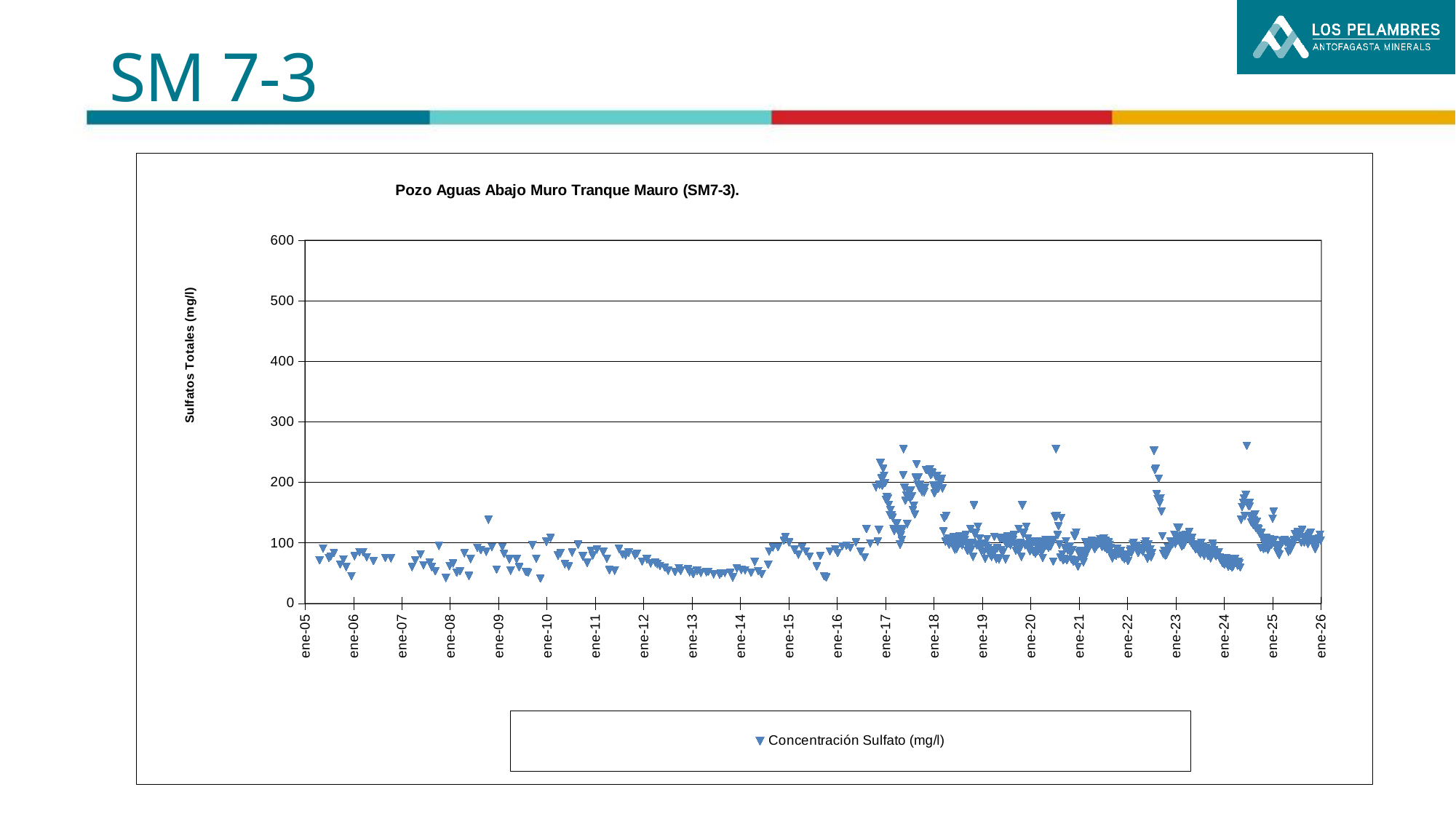
Do the plotted values generally rise or fall between ene-14 and ene-17? rise How many series does the legend list? 1 Is the lowest plotted value on the chart greater or less than 100? less Is the highest value plotted between ene-17 and ene-18 greater or less than 200? greater What kind of chart is shown on the slide? scatter chart Do the plotted values generally rise or fall between ene-12 and ene-14? fall What is the title of the chart? Pozo Aguas Abajo Muro Tranque Mauro (SM7-3). Are the values plotted around ene-13 greater or less than 100? less Are the values plotted around ene-17 higher or lower than those plotted around ene-13? higher What is the series name shown in the legend? Concentración Sulfato (mg/l)